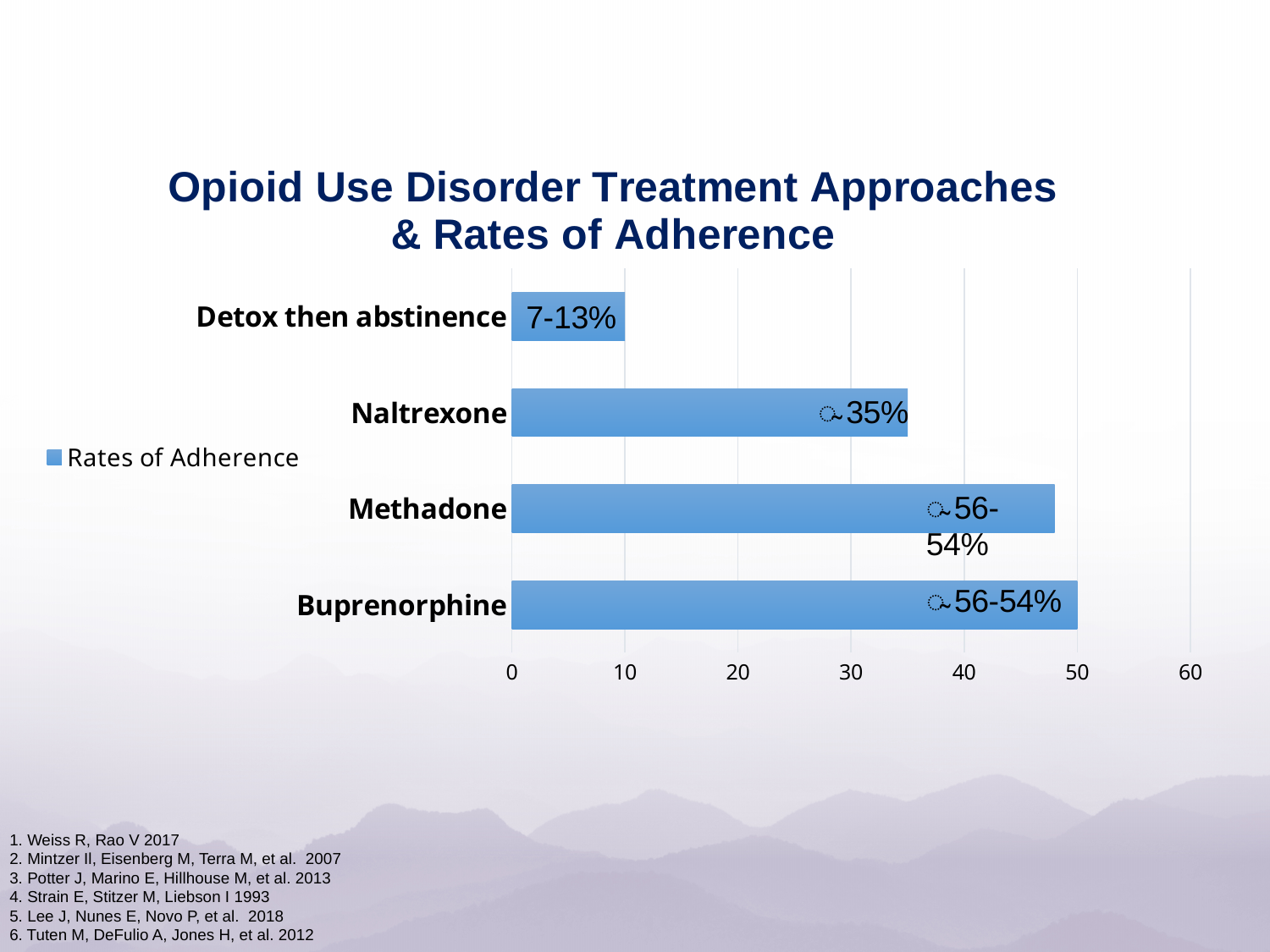
What is the name of the series shown in the chart legend? Rates of Adherence Is the bar for Methadone greater or less than 40? greater Which bar is longer, Naltrexone or Buprenorphine? Buprenorphine Is the bar for Naltrexone greater or less than 30? greater What data label is shown on the bar for Detox then abstinence? 7-13% How many series does the chart legend list? 1 What is the title of the chart on the slide? Opioid Use Disorder Treatment Approaches & Rates of Adherence What kind of chart is shown on the slide? bar chart Which treatment approach has the lowest rate of adherence in the chart? Detox then abstinence Is the bar for Detox then abstinence greater or less than 20? less How many treatment approaches are plotted in the chart? 4 Which bar is longer, Detox then abstinence or Methadone? Methadone